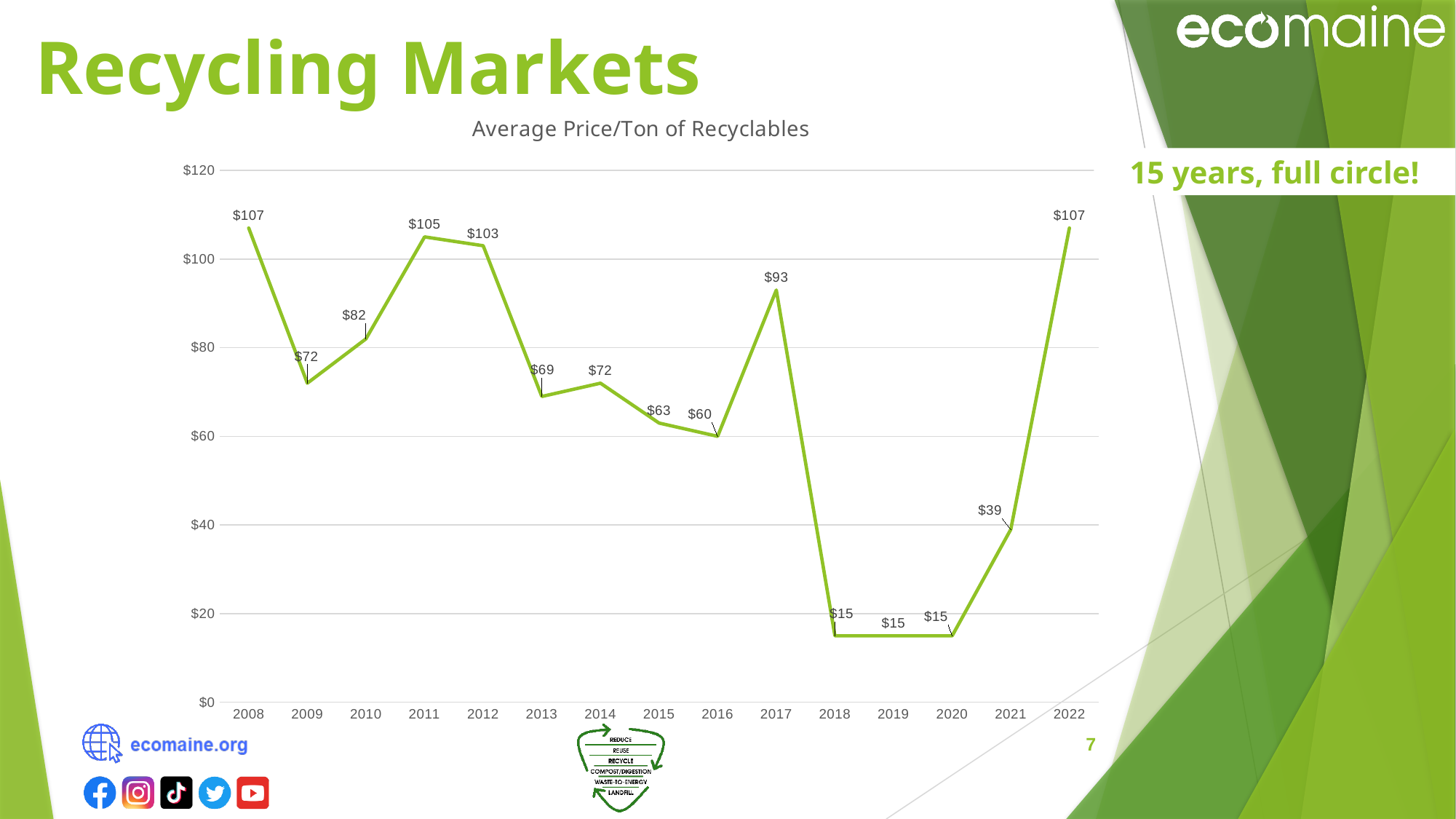
What is the difference between the 2008 value and the 2009 value? $35 How many years are plotted on the chart? 15 What kind of chart is shown on the slide? line chart What is the lowest value plotted on the chart? $15 What is the difference between the 2017 value and the 2018 value? $78 What is the highest value plotted on the chart? $107 Do the values rise or fall from 2012 to 2016? fall What is the average price per ton of recyclables in 2011? $105 Which year has the larger value, 2010 or 2013? 2010 Is the value for 2016 greater or less than $80? less What is the value shown for 2021? $39 What is the value shown for 2017? $93